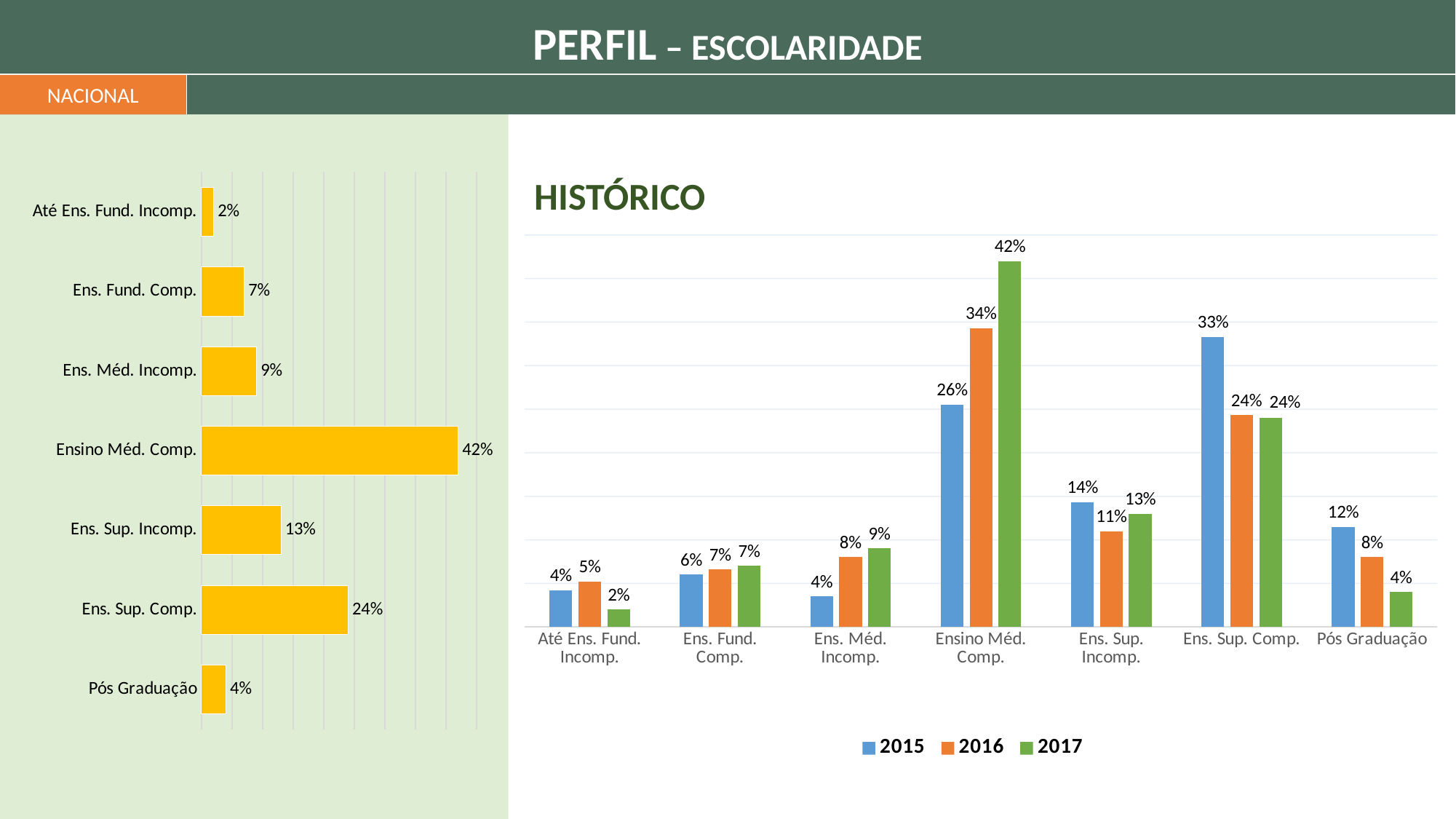
In the HISTÓRICO chart, which category has the highest value for 2017? Ensino Méd. Comp. In the left-hand bar chart, what is the difference between Ens. Sup. Comp. and Ens. Sup. Incomp.? 11% In the HISTÓRICO chart, do the values for Ens. Sup. Comp. rise or fall from 2015 to 2017? Fall In the left-hand bar chart, how many categories are shown? 7 In the HISTÓRICO chart, how many series does the legend list? 3 In the left-hand bar chart, what is the value for Ensino Méd. Comp.? 42% In the left-hand bar chart, which category has the lowest value? Até Ens. Fund. Incomp. In the HISTÓRICO chart, is the 2016 value for Ens. Sup. Incomp. larger or smaller than the 2015 value? Smaller In the HISTÓRICO chart, what is the value for Ens. Sup. Comp. in 2015? 33% What kind of chart is the left-hand chart? Bar chart In the HISTÓRICO chart, what is the difference between the 2017 and 2015 values for Ensino Méd. Comp.? 16% In the HISTÓRICO chart, what is the value for Pós Graduação in 2017? 4%